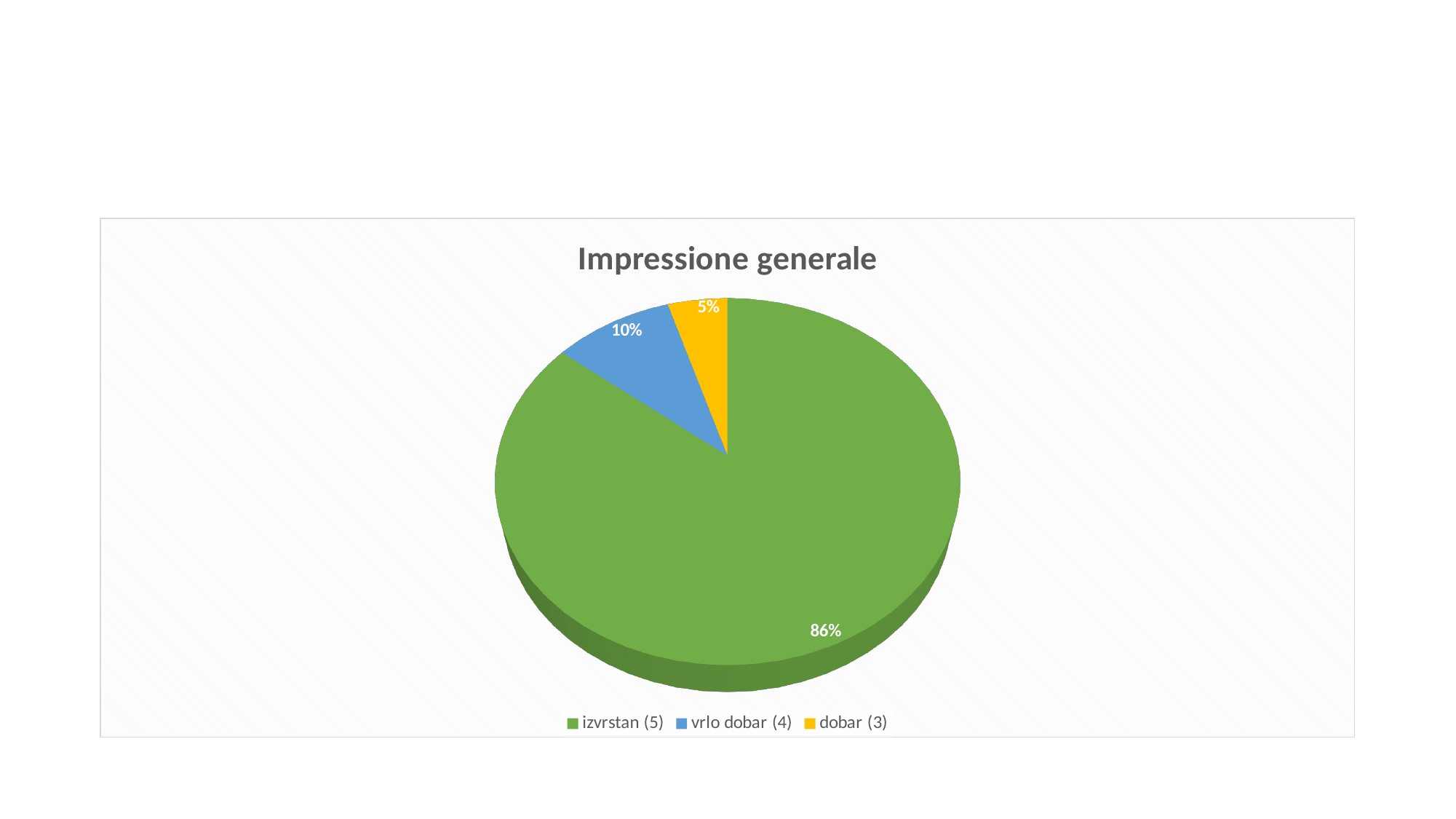
What share of the pie does "izvrstan (5)" take? 86% What colour is the slice for "dobar (3)"? yellow What type of chart is shown on the slide? pie chart What is the difference in percentage points between "vrlo dobar (4)" and "dobar (3)"? 5 Which is larger, the share for "vrlo dobar (4)" or the share for "dobar (3)"? vrlo dobar (4) Which category has the smallest slice of the pie? dobar (3) What is the title of the chart? Impressione generale Which category has the largest slice of the pie? izvrstan (5) What share of the pie does "vrlo dobar (4)" take? 10% What is the difference in percentage points between "izvrstan (5)" and "vrlo dobar (4)"? 76 What share of the pie does "dobar (3)" take? 5% How many categories does the legend list? 3